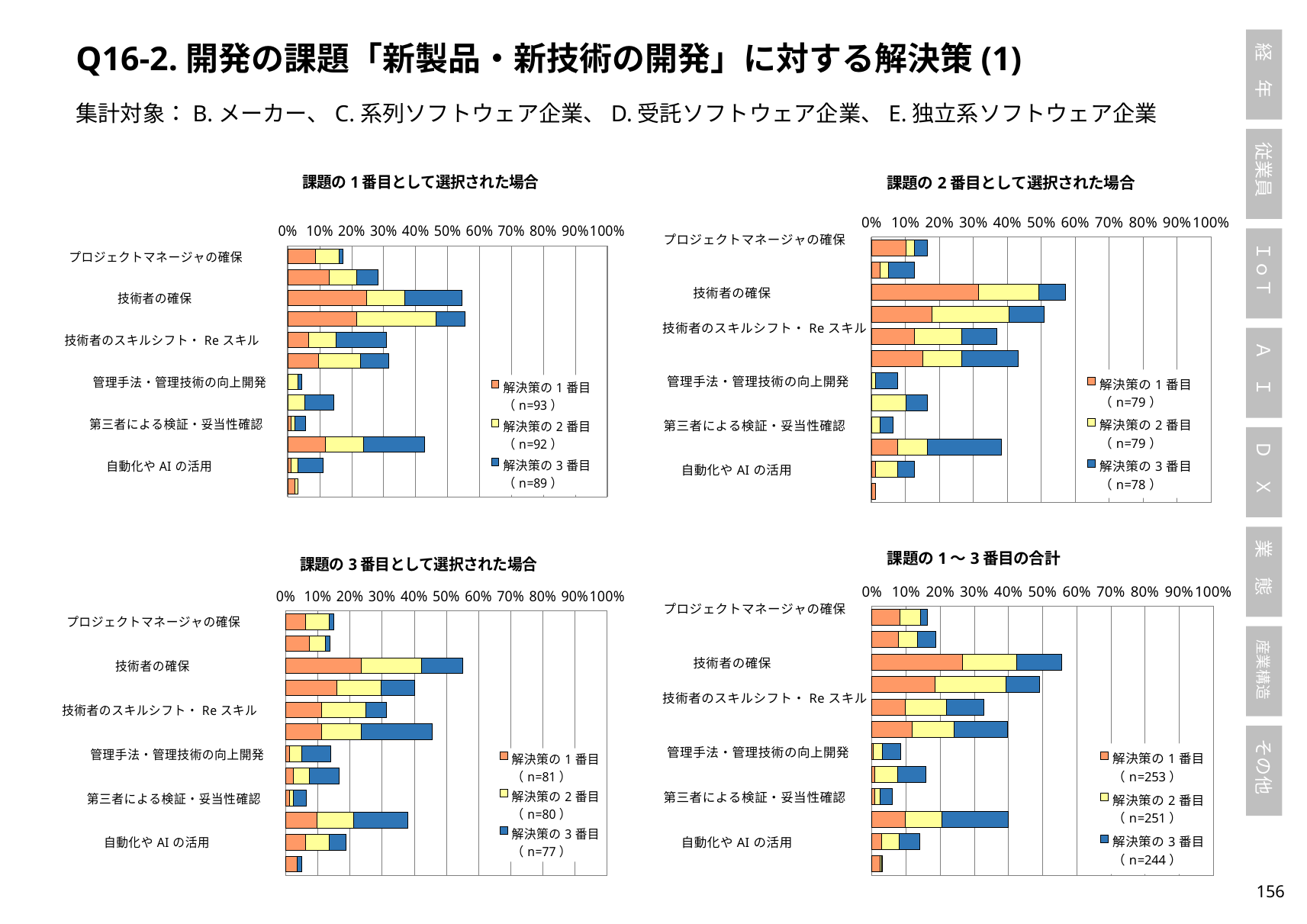
How many charts are shown on the slide? 4 In the bottom-right chart (課題の1～3番目の合計), what is the n value shown in the legend for 解決策の1番目? n=253 In the top-left chart (課題の1番目として選択された場合), what is the n value shown in the legend for 解決策の1番目? n=93 In the top-right chart (課題の2番目として選択された場合), is the total of the longest stacked bar greater or less than 50%? greater In the bottom-right chart (課題の1～3番目の合計), is the total of the longest stacked bar greater or less than 50%? greater In the top-right chart (課題の2番目として選択された場合), what is the n value shown in the legend for 解決策の3番目? n=78 In the bottom-left chart (課題の3番目として選択された場合), is the total of the longest stacked bar greater or less than 70%? less What kind of chart is the top-left chart titled 課題の1番目として選択された場合? stacked bar chart How many series does the legend of the top-left chart (課題の1番目として選択された場合) list? 3